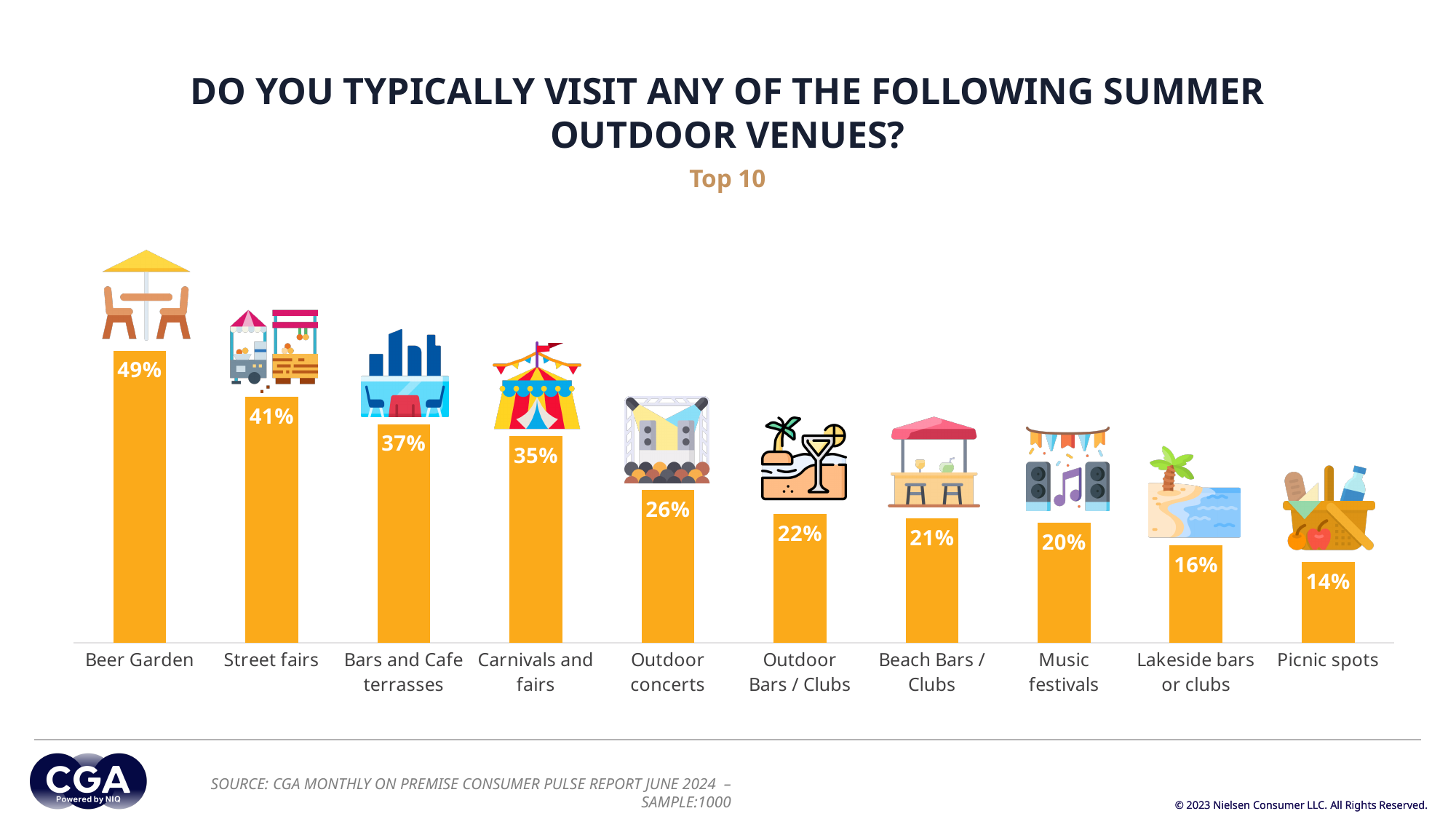
What is the value shown for Outdoor concerts? 26% Which venue has the highest percentage? Beer Garden How many venue categories are shown in the chart? 10 What is the subtitle shown below the chart title? Top 10 What is the difference between the values for Street fairs and Bars and Cafe terrasses? 4% What percentage of respondents typically visit a Beer Garden? 49% What percentage is shown for Lakeside bars or clubs? 16% What is the difference between the values for Beer Garden and Picnic spots? 35% What kind of chart is shown on the slide? Bar chart Which venue has the lowest percentage? Picnic spots Which is larger, the value for Carnivals and fairs or the value for Outdoor Bars / Clubs? Carnivals and fairs Do the values rise or fall from left to right across the chart? Fall